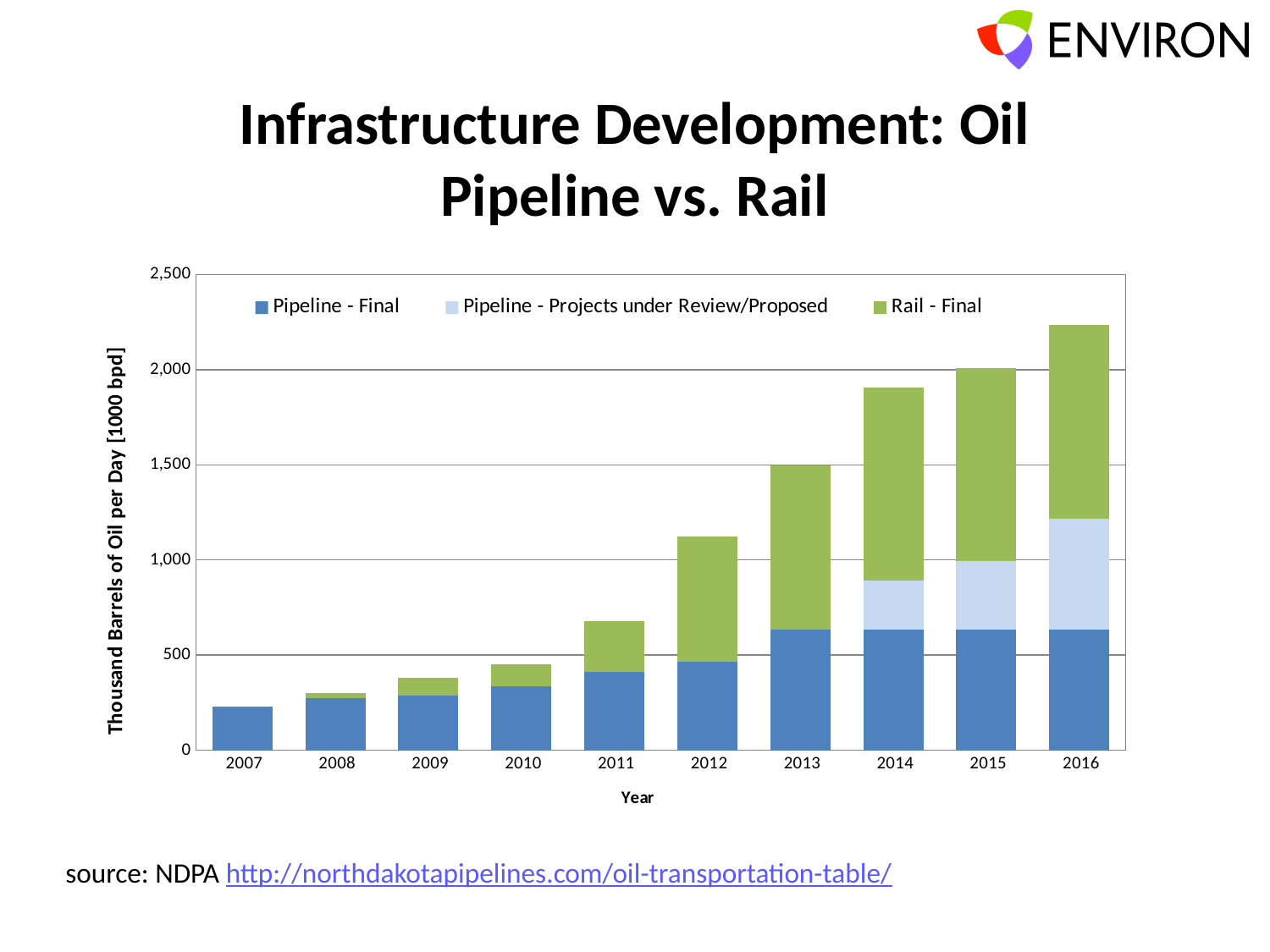
Do the total bar heights rise or fall from 2007 to 2016? Rise How many years are shown on the x axis? 10 How many series does the legend list? 3 Which year has the larger total bar, 2012 or 2013? 2013 What kind of chart is shown on the slide? Stacked bar chart Is the total value for 2016 greater or less than 2,000? greater Is the total value for 2012 greater or less than 1,000? greater Which year has the lowest total bar? 2007 Which year has the highest total bar? 2016 What is the title of the y axis? Thousand Barrels of Oil per Day [1000 bpd] Is the total value for 2007 greater or less than 500? less Which series is shown in green? Rail - Final